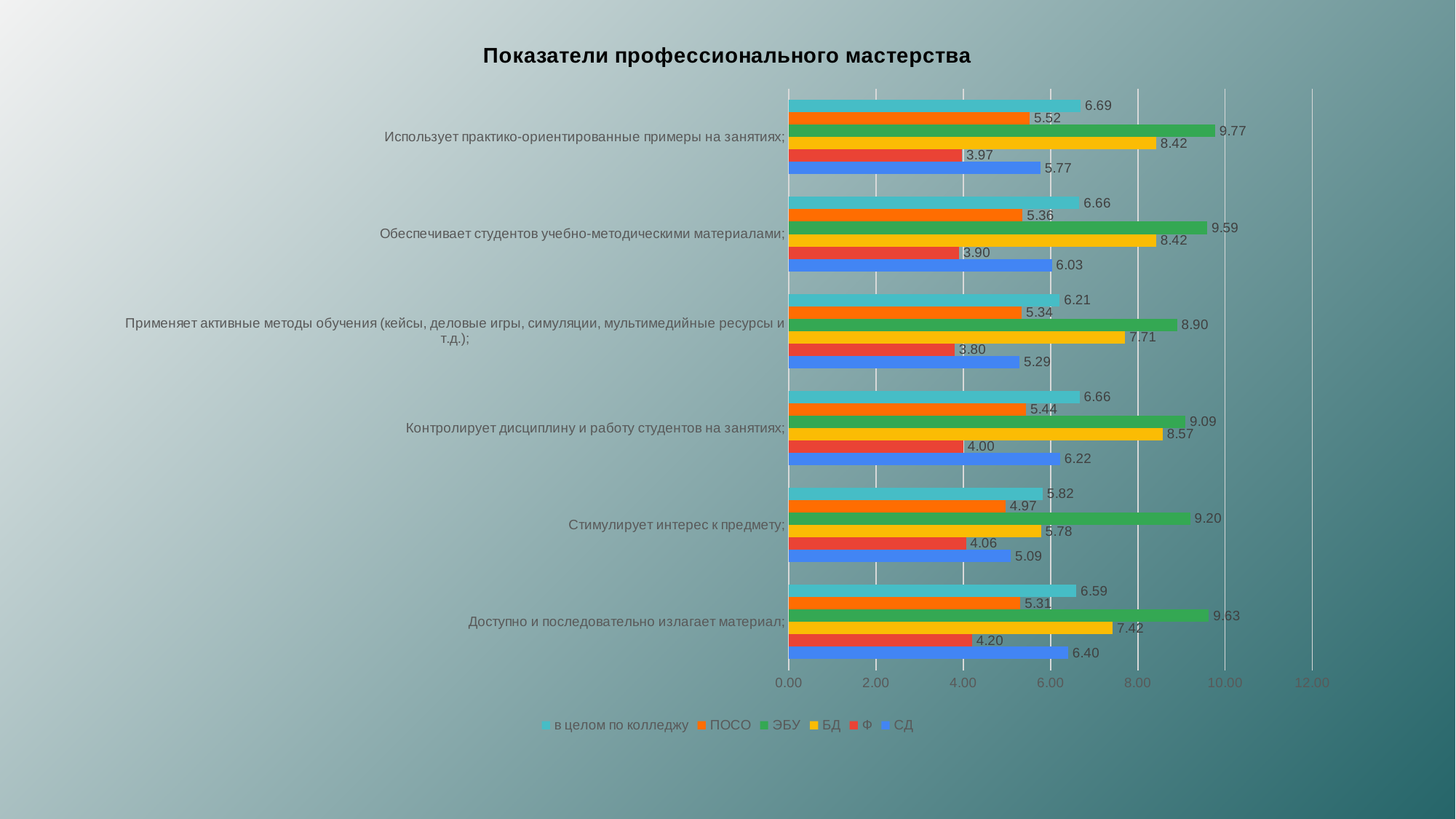
In the category "Стимулирует интерес к предмету", which is larger: the value for БД or the value for в целом по колледжу? в целом по колледжу Which series has the highest value in the category "Контролирует дисциплину и работу студентов на занятиях"? ЭБУ How many series does the legend list? 6 What is the value for СД in the category "Доступно и последовательно излагает материал"? 6.40 What is the value for ЭБУ in the category "Использует практико-ориентированные примеры на занятиях"? 9.77 What type of chart is shown on the slide? Bar chart In which category does ЭБУ have its lowest value? Применяет активные методы обучения (кейсы, деловые игры, симуляции, мультимедийные ресурсы и т.д.) What is the title of the chart? Показатели профессионального мастерства What is the value for Ф in the category "Стимулирует интерес к предмету"? 4.06 Which series has the lowest value in the category "Обеспечивает студентов учебно-методическими материалами"? Ф What is the difference between the ЭБУ and Ф values in the category "Применяет активные методы обучения (кейсы, деловые игры, симуляции, мультимедийные ресурсы и т.д.)"? 5.10 How many categories are shown on the chart? 6